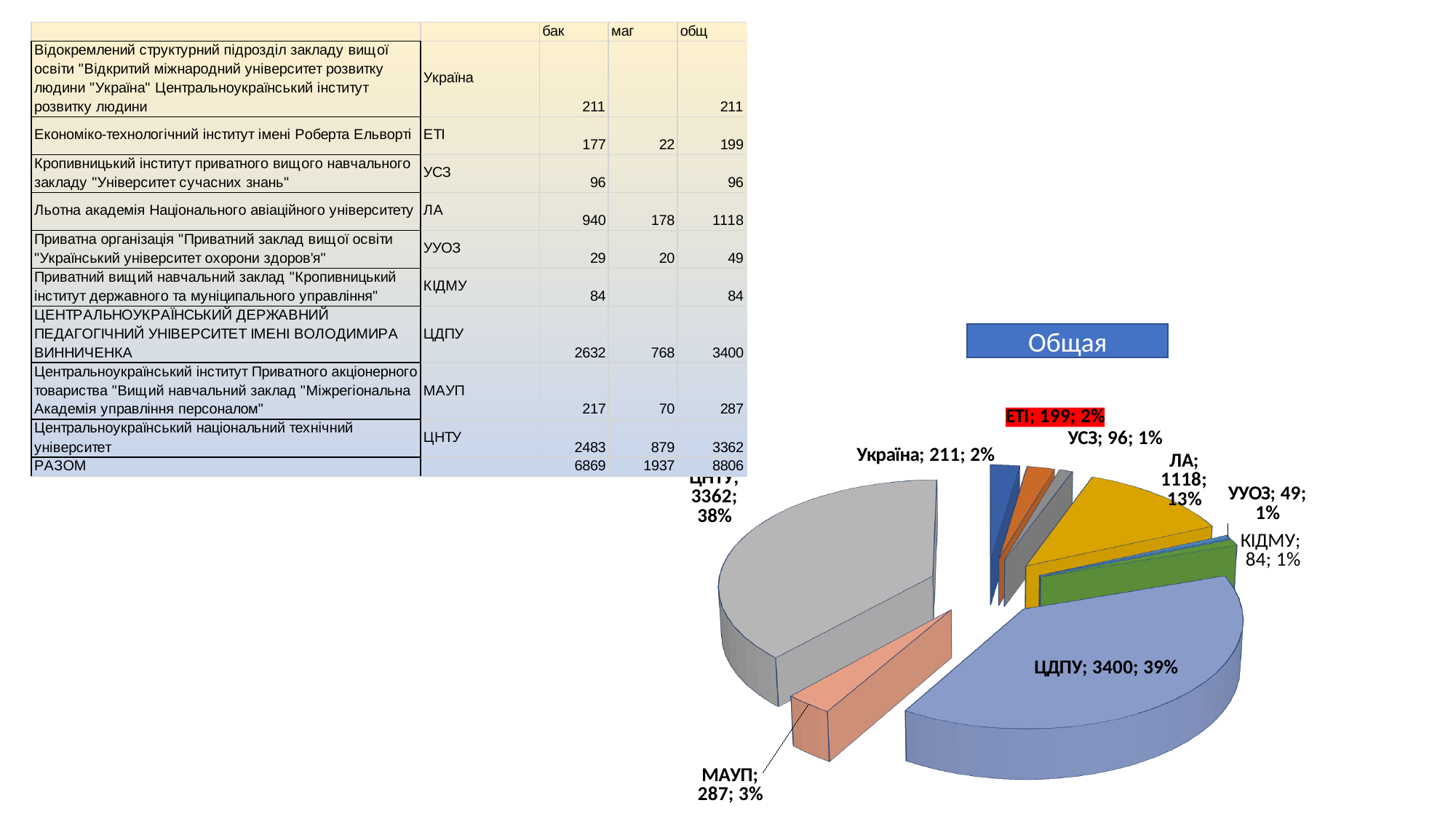
What is the value shown for МАУП in the pie chart? 287 What is the value shown for ЛА in the pie chart? 1118 What share of the pie does ЛА represent? 13% Which is larger in the pie chart, the value for ЛА or the value for МАУП? ЛА How many slices does the pie chart have? 9 Which category has the largest slice in the pie chart? ЦДПУ What is the title of the pie chart? Общая What share of the pie does ЦНТУ represent? 38% What is the difference between the values for ЦДПУ and ЦНТУ in the pie chart? 38 Which category has the smallest slice in the pie chart? УУОЗ What kind of chart is shown on the slide? pie chart What is the value shown for ЦДПУ in the pie chart? 3400